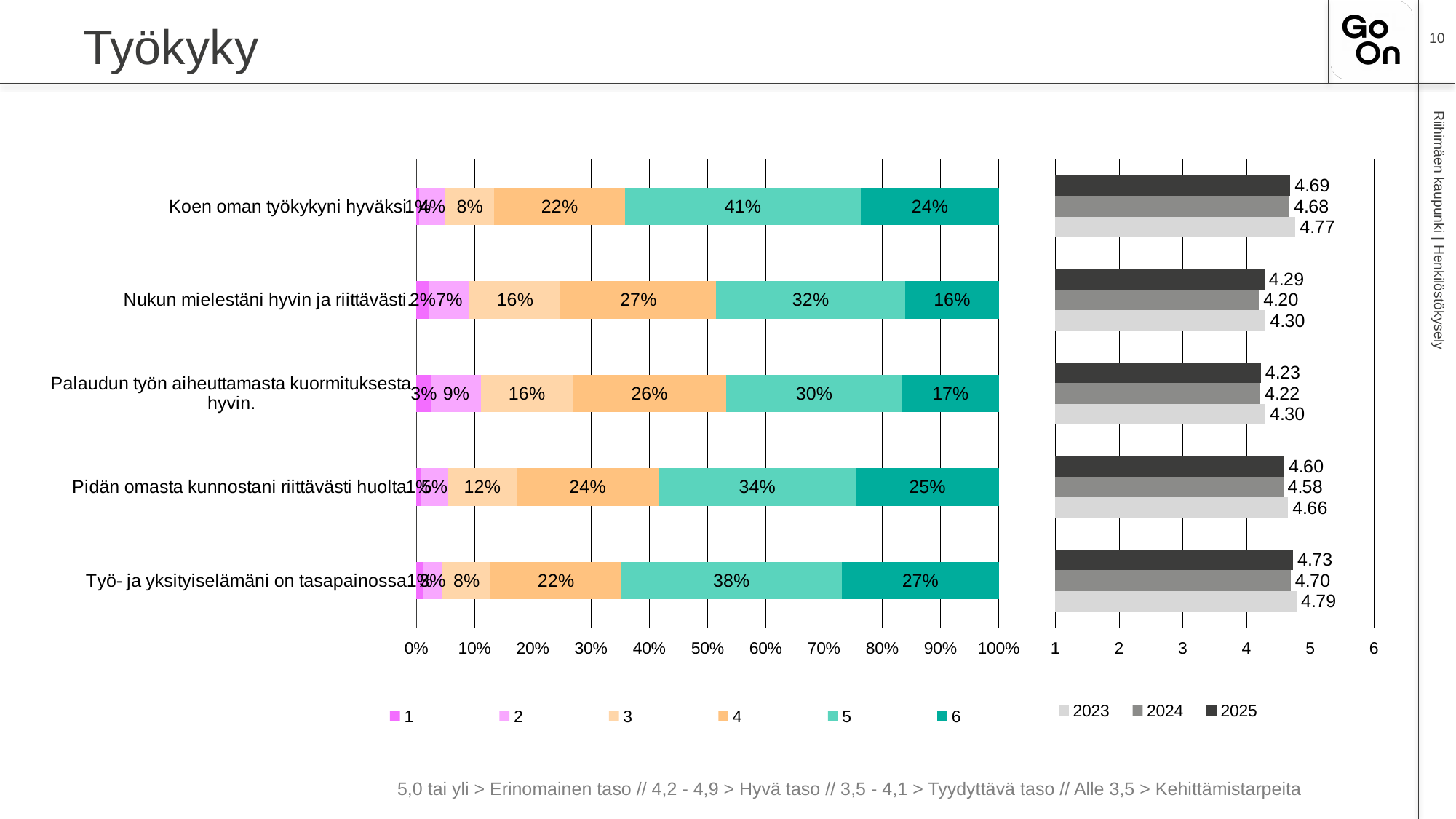
In the right chart, which statement has the highest 2025 average? Työ- ja yksityiselämäni on tasapainossa In the left stacked bar chart, what is the difference between the rating-6 share for "Pidän omasta kunnostani riittävästi huolta" and for "Nukun mielestäni hyvin ja riittävästi"? 9% In the right chart, what is the 2025 average for "Koen oman työkykyni hyväksi"? 4.69 In the right chart, which is larger for "Nukun mielestäni hyvin ja riittävästi": the 2024 average or the 2025 average? 2025 In the left stacked bar chart, how many statements (categories) are shown? 5 In the left stacked bar chart, how many series does the legend list? 6 In the left stacked bar chart, what percentage of respondents gave a rating of 4 for "Nukun mielestäni hyvin ja riittävästi"? 27% What type of chart is the right chart? Bar chart In the left stacked bar chart, what percentage of respondents gave a rating of 5 for "Koen oman työkykyni hyväksi"? 41% In the left stacked bar chart, what percentage of respondents gave a rating of 6 for "Työ- ja yksityiselämäni on tasapainossa"? 27% In the left stacked bar chart, which statement has the highest share of rating 5? Koen oman työkykyni hyväksi In the right chart, what is the 2023 average for "Palaudun työn aiheuttamasta kuormituksesta hyvin"? 4.30